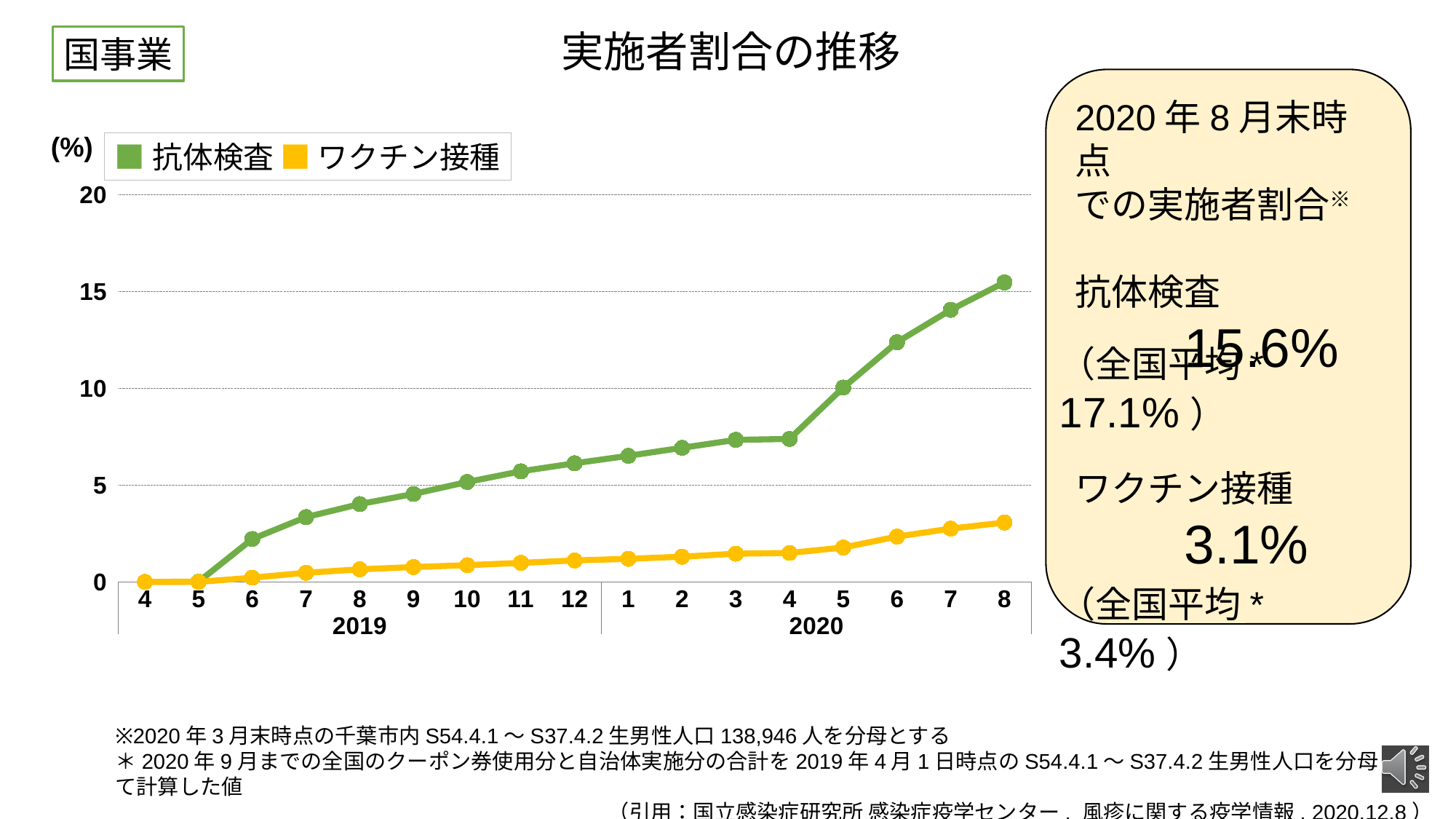
What kind of chart is shown on the slide? line chart What is the value of 抗体検査 at the end of August 2020 (month 8 of 2020)? 15.6% Is the value for ワクチン接種 at month 8 of 2020 greater or less than 5? less Is the value for 抗体検査 at month 6 of 2020 greater or less than 10? greater What are the two series named in the legend? 抗体検査 and ワクチン接種 What is the difference between 抗体検査 and ワクチン接種 at month 8 of 2020? 12.5 percentage points Does the 抗体検査 line rise or fall from month 4 of 2019 to month 8 of 2020? rise Which series is higher at month 1 of 2020, 抗体検査 or ワクチン接種? 抗体検査 What is the value of ワクチン接種 at the end of August 2020 (month 8 of 2020)? 3.1% Is the value for 抗体検査 at month 4 of 2020 greater or less than 10? less How many monthly data points are plotted along the x axis for each series? 17 How many series does the legend list? 2